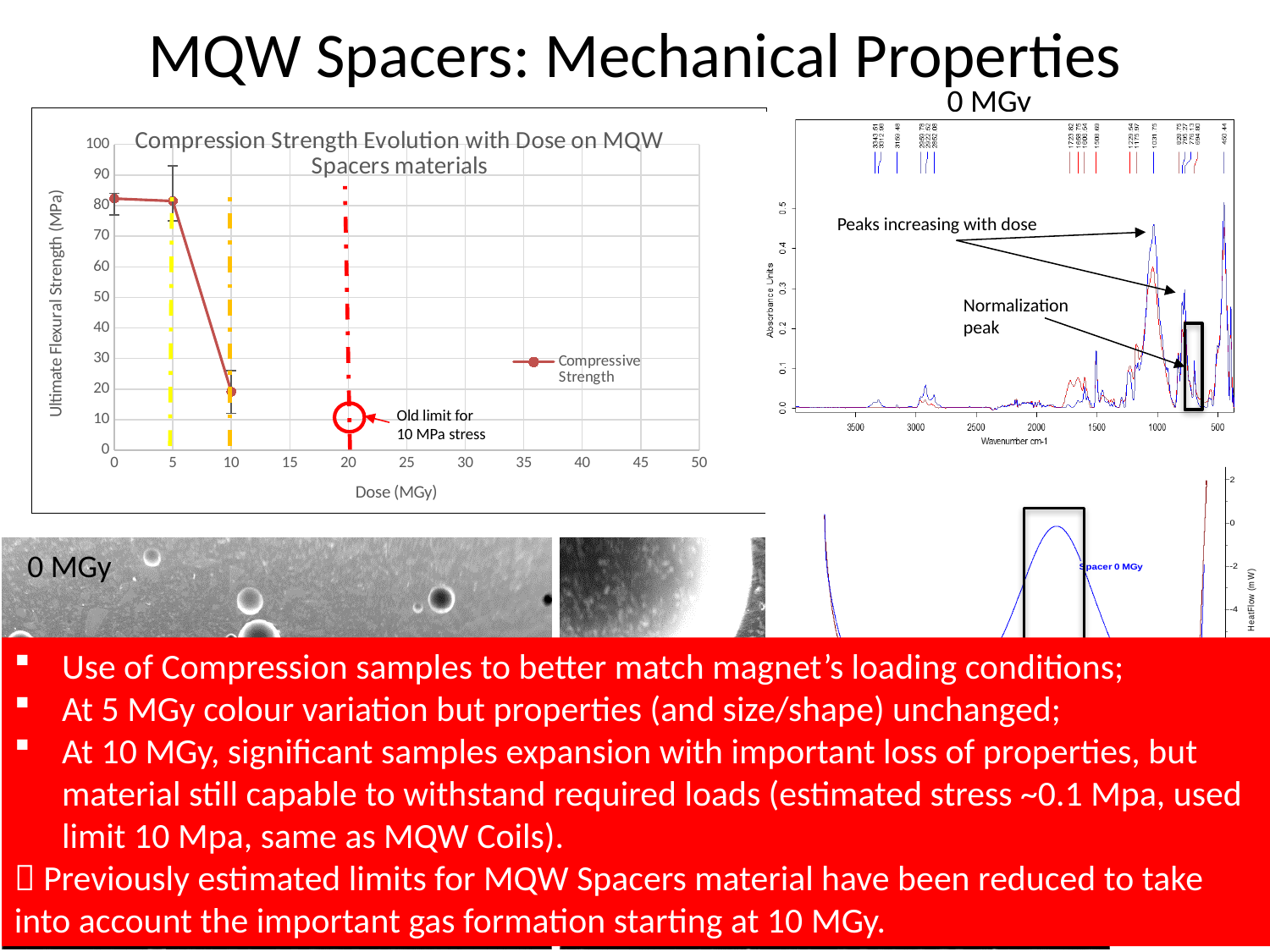
In the Compression Strength Evolution chart, what series name is shown in the legend? Compressive Strength In the Compression Strength Evolution chart, how many data points are plotted? 3 In the Compression Strength Evolution chart, what kind of chart is it? Line chart In the Compression Strength Evolution chart, is the value at 0 MGy greater or less than 70? greater In the Compression Strength Evolution chart, do the values rise or fall as dose increases from 0 to 10 MGy? fall In the Compression Strength Evolution chart, is the value at 10 MGy greater or less than 30? less In the Compression Strength Evolution chart, what is the x-axis title? Dose (MGy) In the Compression Strength Evolution chart, how many series does the legend list? 1 In the Compression Strength Evolution chart, which is larger, the value at 5 MGy or the value at 10 MGy? 5 MGy In the Compression Strength Evolution chart, is the value at 5 MGy greater or less than 60? greater In the Compression Strength Evolution chart, at which dose is the plotted strength lowest? 10 MGy